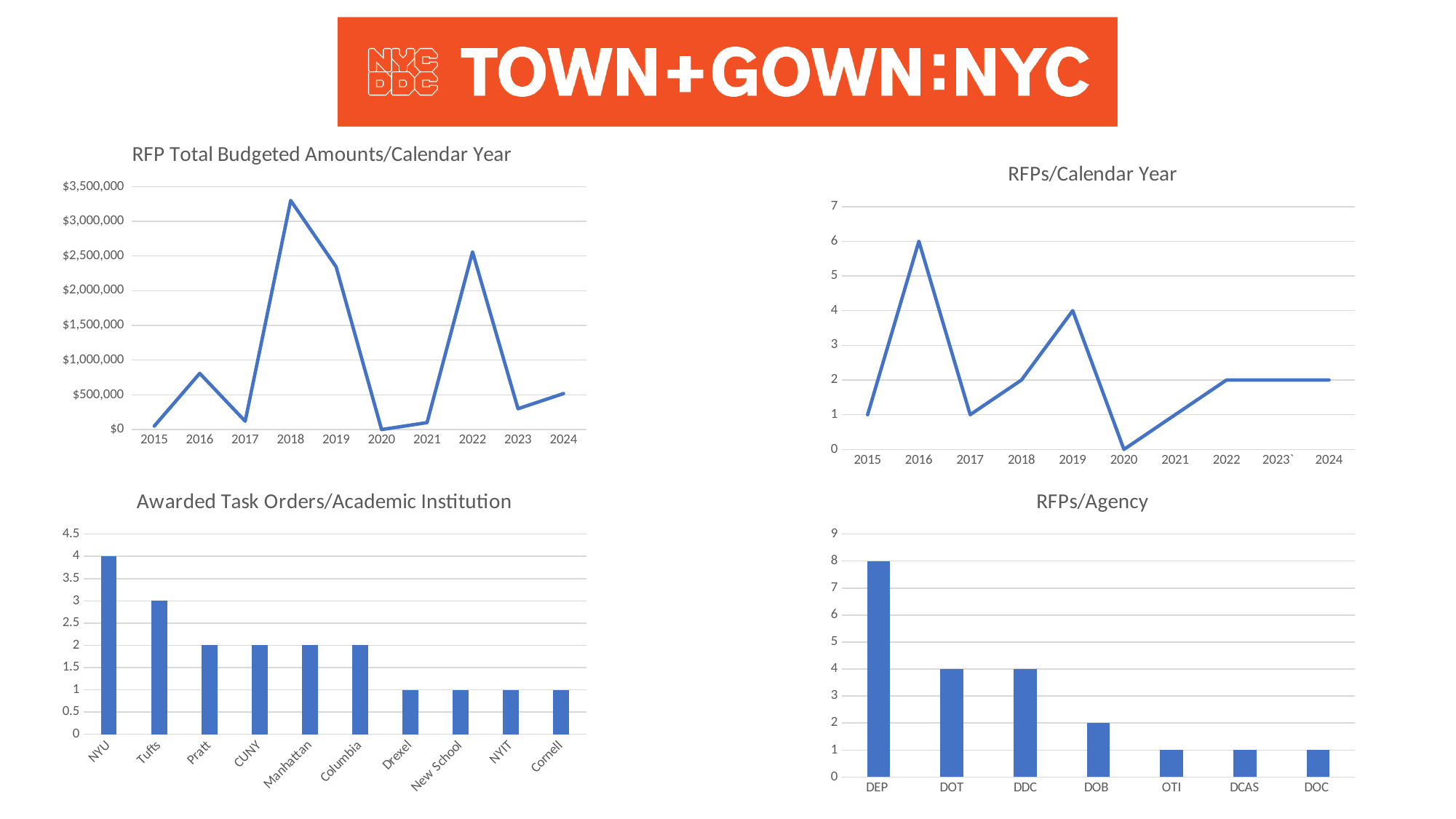
In the RFPs/Agency chart, which is larger, the value for DOB or the value for OTI? DOB In the RFPs/Agency chart, how many agencies are shown on the x axis? 7 In the RFPs/Agency chart, what is the value for DEP? 8 In the Awarded Task Orders/Academic Institution chart, what is the difference between the values for NYU and Cornell? 3 In the RFPs/Calendar Year chart, what is the difference between the values for 2019 and 2018? 2 In the Awarded Task Orders/Academic Institution chart, what is the value for Tufts? 3 What kind of chart is the RFPs/Agency chart? bar chart In the RFP Total Budgeted Amounts/Calendar Year chart, which year has the highest value? 2018 In the RFP Total Budgeted Amounts/Calendar Year chart, is the value for 2018 greater or less than $3,000,000? greater In the RFPs/Calendar Year chart, what is the value for 2016? 6 In the RFPs/Calendar Year chart, which year has the lowest value? 2020 In the Awarded Task Orders/Academic Institution chart, which institution has the highest value? NYU